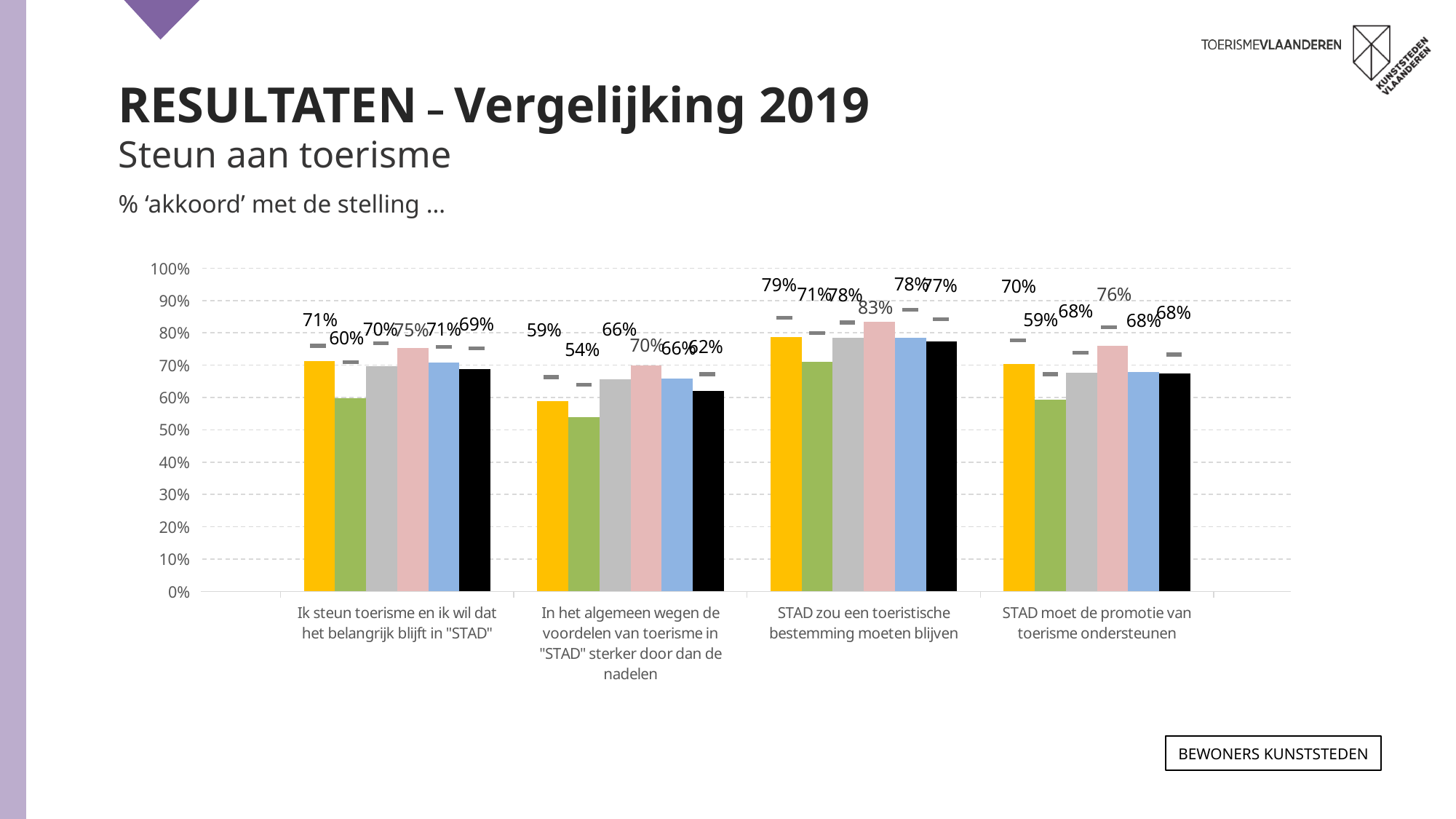
What is the value of the pink bar for "Ik steun toerisme en ik wil dat het belangrijk blijft in "STAD""? 75% How many statement categories are shown along the x axis? 4 Which bar is the lowest for "STAD moet de promotie van toerisme ondersteunen"? the green bar (59%) What kind of chart is shown on the slide? bar chart What is the difference between the pink bar and the green bar for "STAD zou een toeristische bestemming moeten blijven"? 12 percentage points What is the value of the green bar for "In het algemeen wegen de voordelen van toerisme in "STAD" sterker door dan de nadelen"? 54% Is the value of the green bar for "Ik steun toerisme en ik wil dat het belangrijk blijft in "STAD"" greater or less than 70%? less Which is larger for "In het algemeen wegen de voordelen van toerisme in "STAD" sterker door dan de nadelen": the yellow bar or the pink bar? the pink bar (70%) What is the value of the yellow bar for "STAD moet de promotie van toerisme ondersteunen"? 70% What is the value of the pink bar for "STAD zou een toeristische bestemming moeten blijven"? 83% Which bar is the highest for "STAD zou een toeristische bestemming moeten blijven"? the pink bar (83%) What is the subtitle text printed above the chart? % ‘akkoord’ met de stelling …